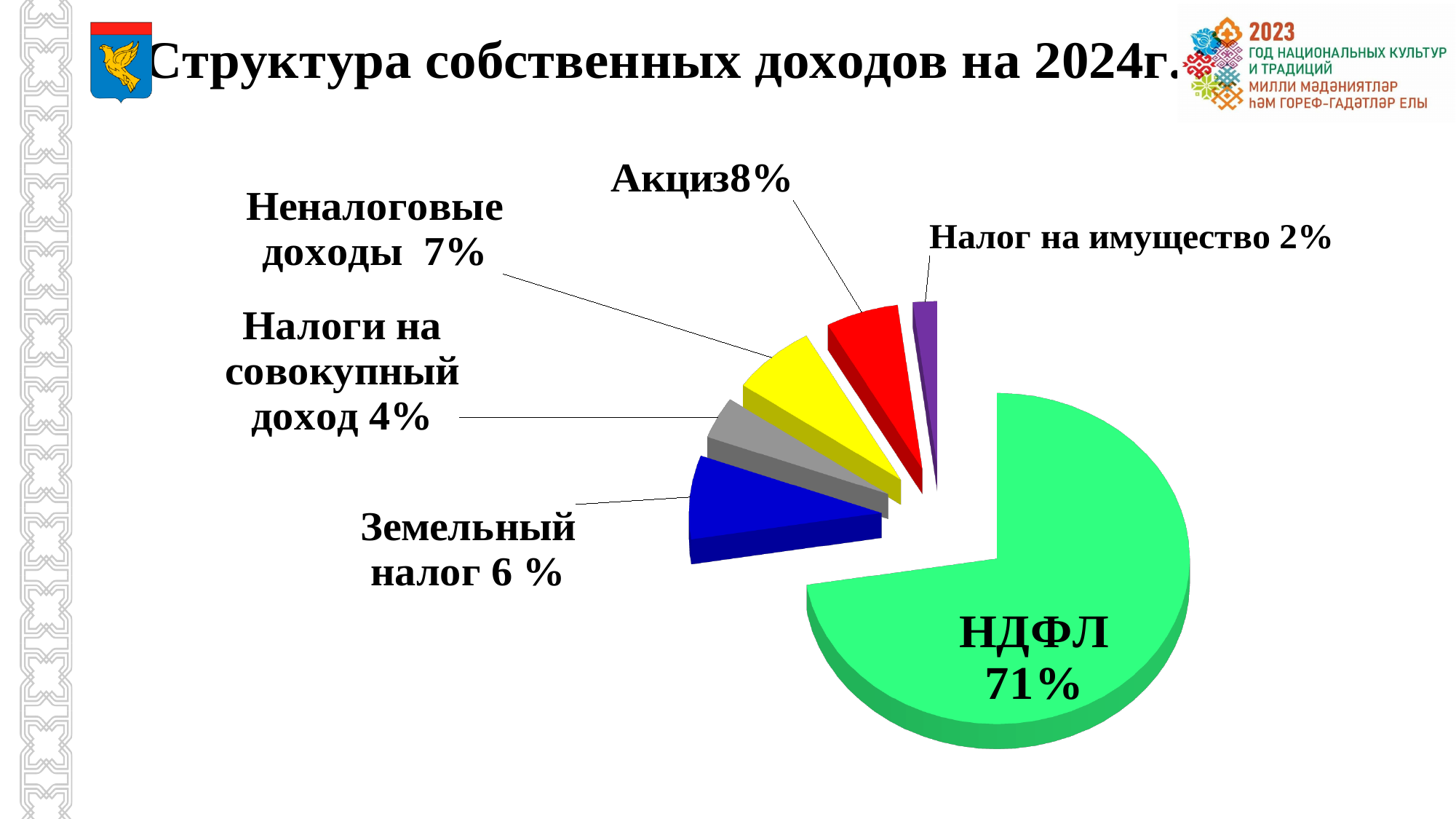
What is the value shown for Налог на имущество? 2% What is the value shown for Акциз? 8% What is the difference between the share for НДФЛ and the share for Акциз? 63% What is the value shown for Неналоговые доходы? 7% How many slices does the pie chart have? 6 What share of own revenues does НДФЛ account for? 71% What kind of chart is shown on the slide? pie chart What is the title of the slide containing the chart? Структура собственных доходов на 2024г. Which category has the smallest share of the pie? Налог на имущество What is the value shown for Земельный налог? 6 % Which is larger, the share for Акциз or the share for Неналоговые доходы? Акциз Which category has the largest share of the pie? НДФЛ